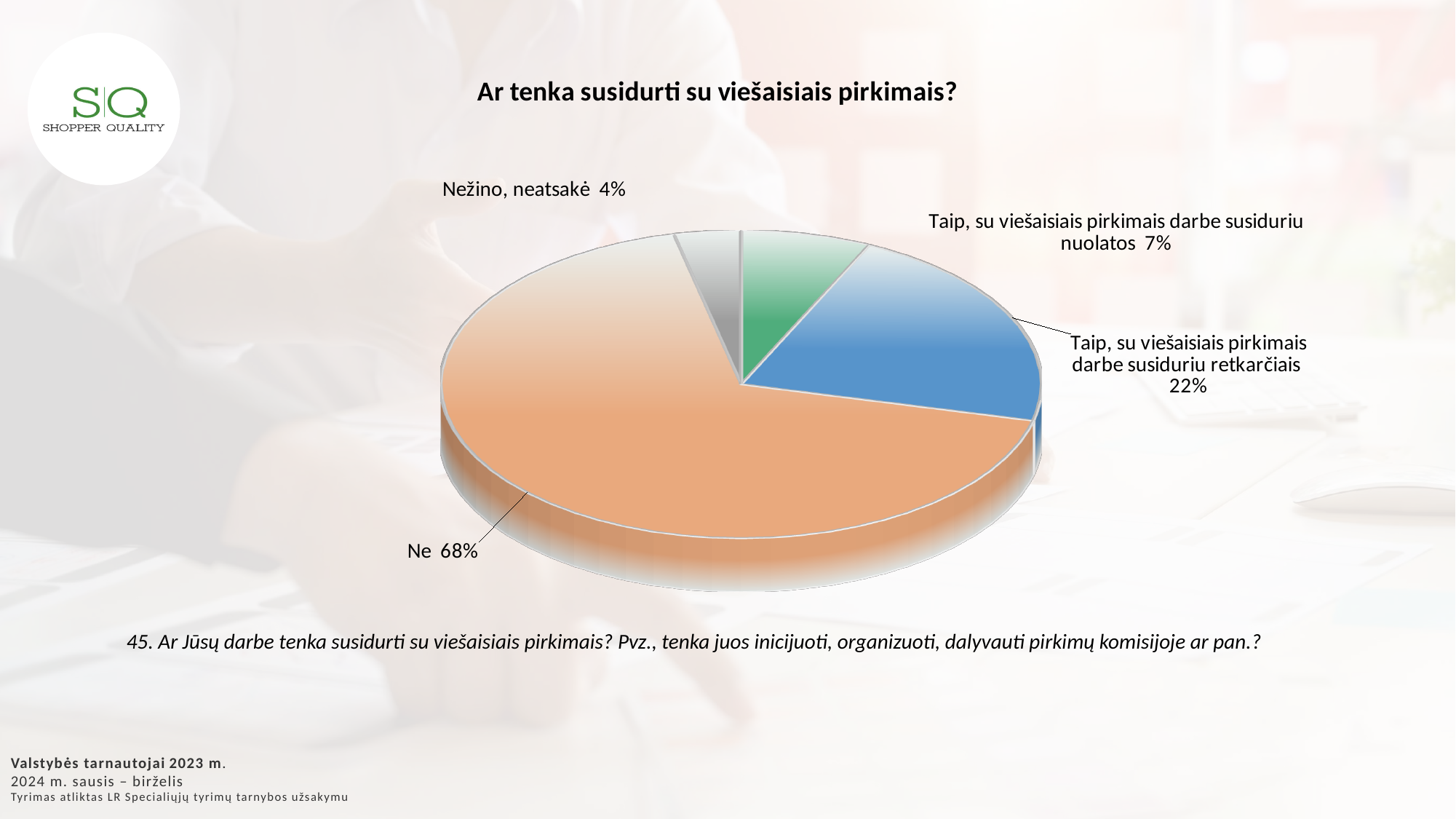
What percentage is shown for "Taip, su viešaisiais pirkimais darbe susiduriu nuolatos"? 7% Which category has the smallest slice of the pie? Nežino, neatsakė What share is shown for "Taip, su viešaisiais pirkimais darbe susiduriu retkarčiais"? 22% What percentage of respondents answered "Ne"? 68% What colour is the "Ne" slice of the pie? Orange What percentage of respondents are in the "Nežino, neatsakė" category? 4% How many categories are shown in the pie chart? 4 Which is larger: the share for "Taip, su viešaisiais pirkimais darbe susiduriu nuolatos" or for "Nežino, neatsakė"? Taip, su viešaisiais pirkimais darbe susiduriu nuolatos What type of chart is shown on the slide? Pie chart What is the difference in percentage points between "Ne" and "Taip, su viešaisiais pirkimais darbe susiduriu retkarčiais"? 46 percentage points What is the title of the chart? Ar tenka susidurti su viešaisiais pirkimais? Which category has the largest slice of the pie? Ne